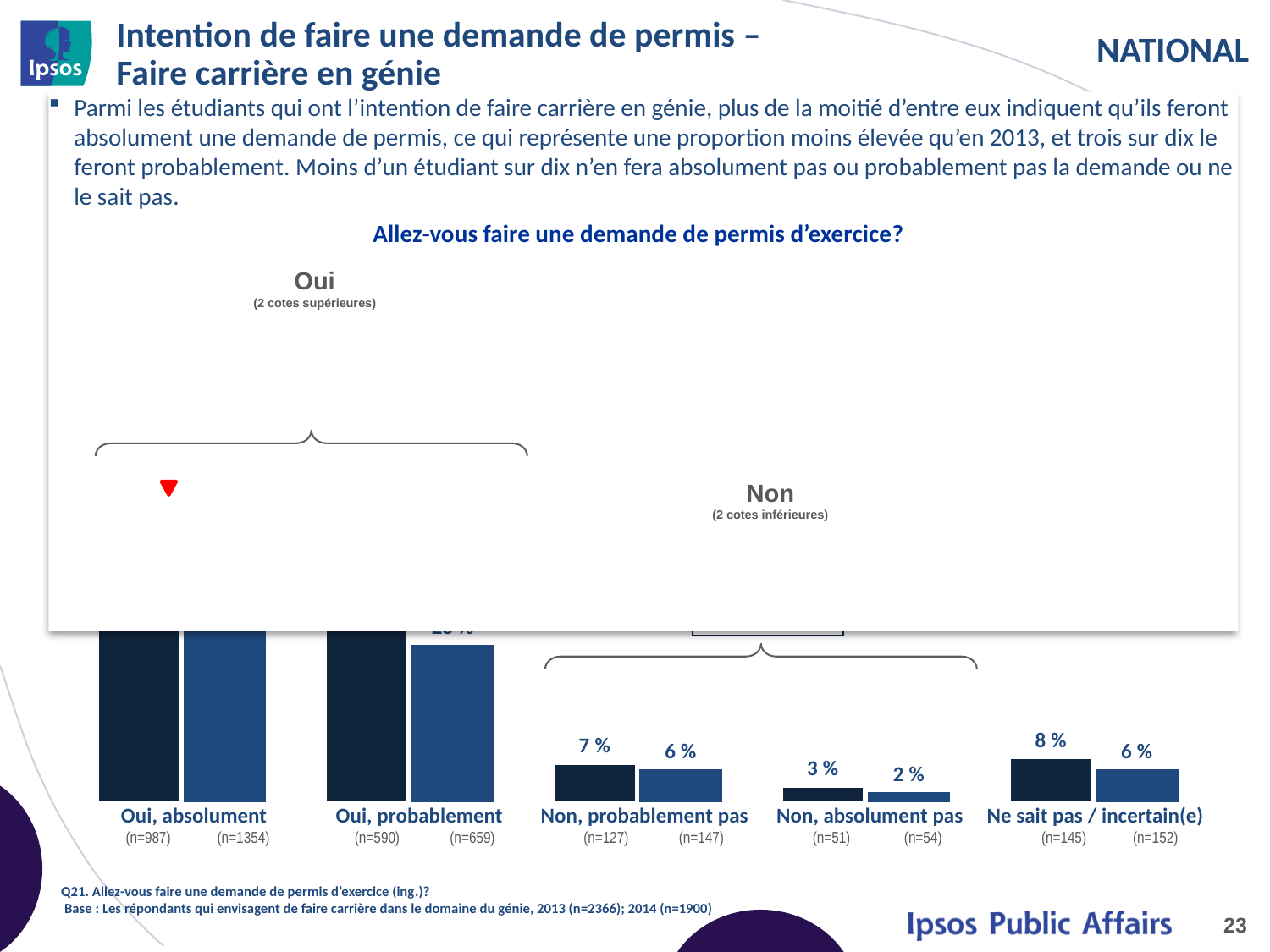
How many response categories are shown along the x axis of the chart? 5 For 'Non, probablement pas', which bar is larger, the darker (left) one or the lighter (right) one? the darker (left) bar What sample size (n) is shown under the darker (left) bar for 'Oui, absolument'? n=987 What is the value of the lighter (right) bar for 'Ne sait pas / incertain(e)'? 6 % What is the value of the darker (left) bar for 'Non, probablement pas'? 7 % What is the difference between the darker and lighter bars for 'Ne sait pas / incertain(e)'? 2 % What is the title of the chart? Allez-vous faire une demande de permis d'exercice? What is the value of the lighter (right) bar for 'Non, absolument pas'? 2 % Which category has the shortest bars in the chart? Non, absolument pas Which category has the tallest bars in the chart? Oui, absolument What is the value of the darker (left) bar for 'Non, absolument pas'? 3 % What kind of chart is shown on the slide? bar chart